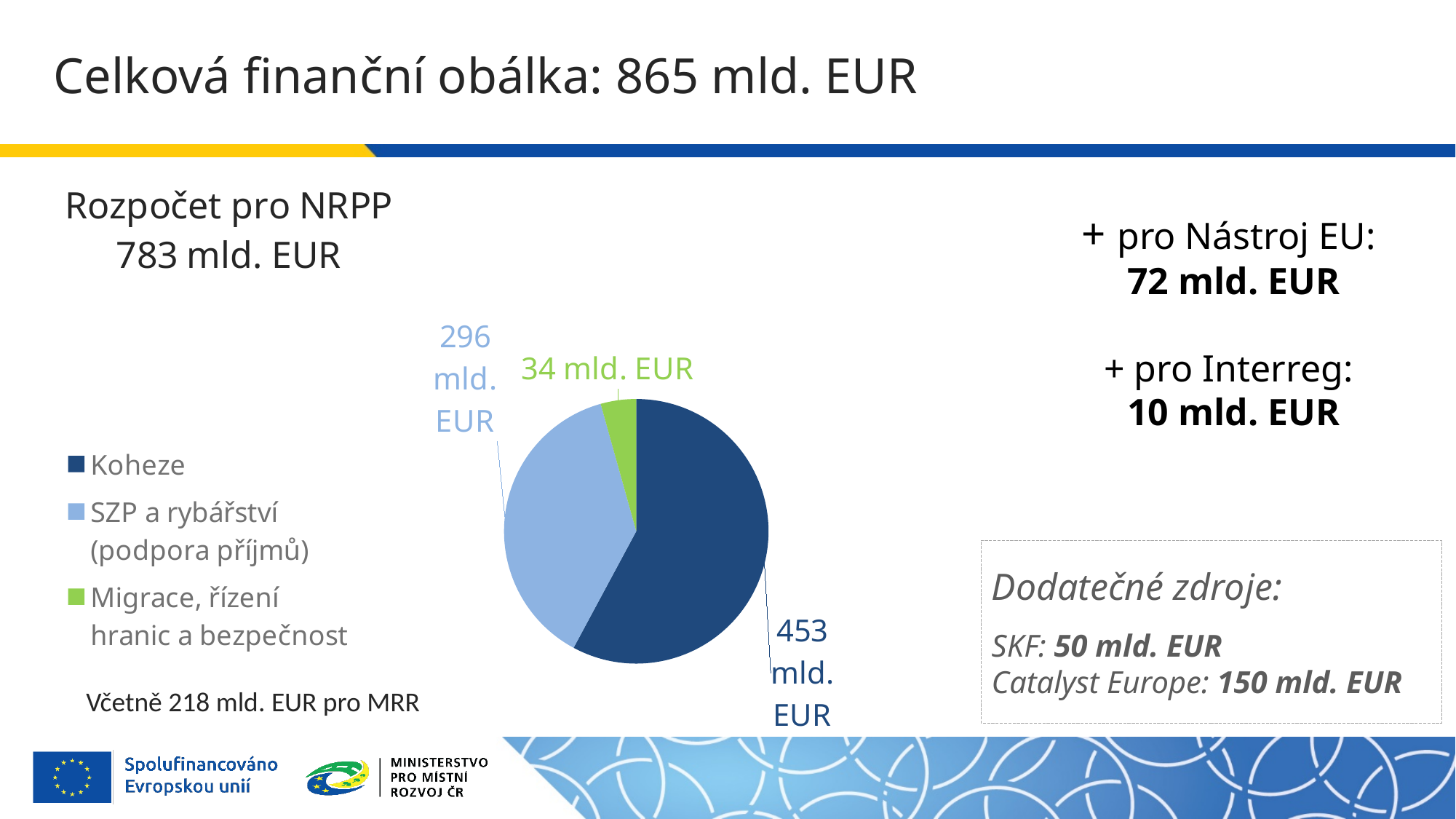
What is the difference between the Koheze slice and the SZP a rybářství (podpora příjmů) slice? 157 mld. EUR Which slice of the pie chart is the largest? Koheze What colour is the Koheze slice in the pie chart? dark blue How many slices does the pie chart have? 3 Which slice of the pie chart is the smallest? Migrace, řízení hranic a bezpečnost What is the value of the SZP a rybářství (podpora příjmů) slice in the pie chart? 296 mld. EUR What is the value of the Koheze slice in the pie chart? 453 mld. EUR What is the total of the three slices in the pie chart? 783 mld. EUR What is the value of the Migrace, řízení hranic a bezpečnost slice in the pie chart? 34 mld. EUR What type of chart is shown on the slide? pie chart Which is larger in the pie chart: SZP a rybářství (podpora příjmů) or Migrace, řízení hranic a bezpečnost? SZP a rybářství (podpora příjmů) How many entries does the legend of the pie chart list? 3